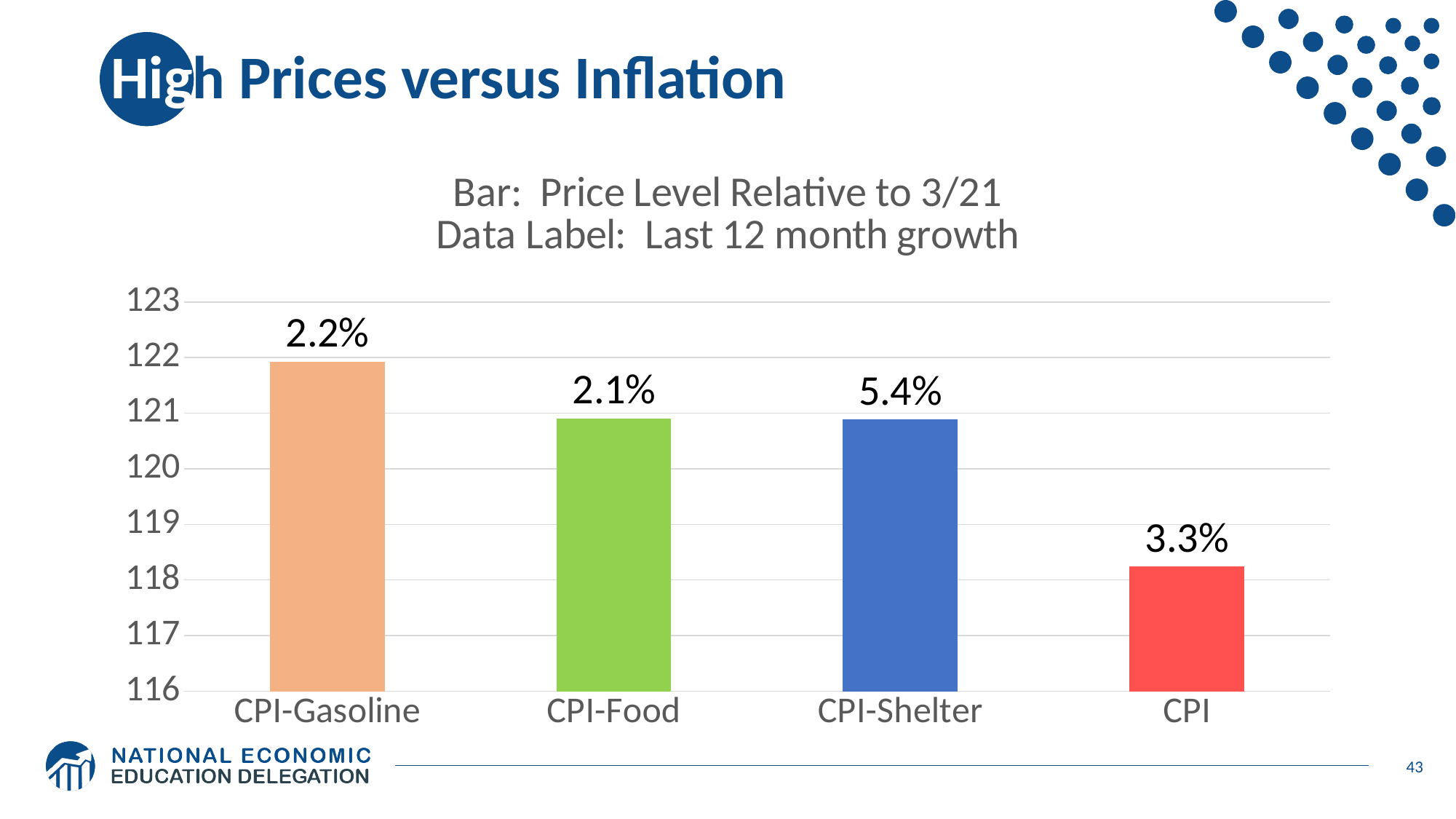
What is the data label (last 12 month growth) shown for CPI-Food? 2.1% Is the bar for CPI (price level relative to 3/21) greater or less than 119? less What is the data label (last 12 month growth) shown for CPI? 3.3% Which category has the highest last 12 month growth data label? CPI-Shelter What is the difference in percentage points between the data labels for CPI-Shelter and CPI? 2.1 percentage points What is the data label (last 12 month growth) shown for CPI-Shelter? 5.4% Which category has the tallest bar (highest price level relative to 3/21)? CPI-Gasoline Which category has the shortest bar (lowest price level relative to 3/21)? CPI What is the data label (last 12 month growth) shown for CPI-Gasoline? 2.2% How many categories are shown on the x axis of the chart? 4 Which category has the lowest last 12 month growth data label? CPI-Food Is the bar for CPI-Gasoline (price level relative to 3/21) greater or less than 121? greater